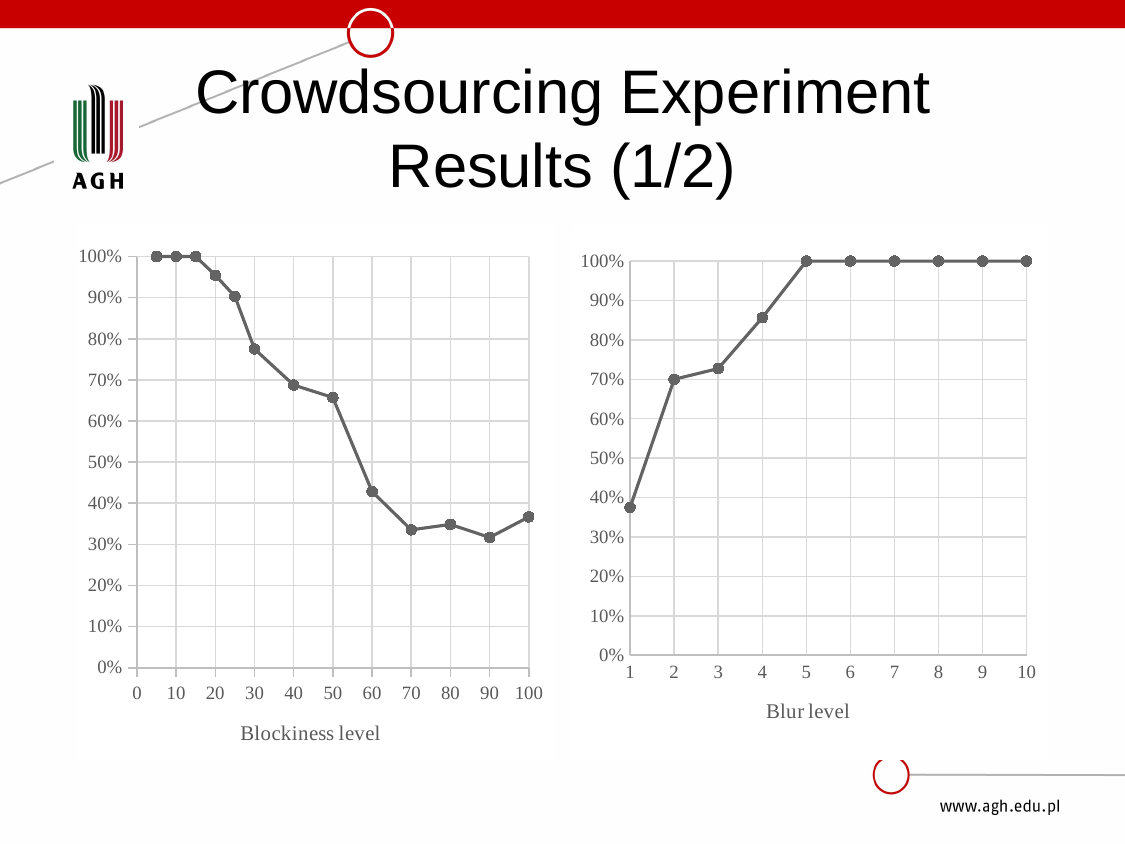
In the Blockiness level chart, is the value at blockiness level 30 greater or less than 70%? greater What kind of chart is the Blur level chart on the right? line chart What kind of chart is the Blockiness level chart on the left? line chart In the Blur level chart, do the values rise or fall as the blur level increases from 1 to 5? rise In the Blur level chart, is the value at blur level 4 greater or less than 80%? greater How many data points are plotted in the Blur level chart? 10 In the Blockiness level chart, what is the value at blockiness level 10? 100% In the Blockiness level chart, which is larger: the value at blockiness level 40 or at blockiness level 60? blockiness level 40 In the Blockiness level chart, is the value at blockiness level 70 greater or less than 40%? less In the Blur level chart, what is the value at blur level 7? 100% In the Blockiness level chart, do the values generally rise or fall as the blockiness level increases? fall